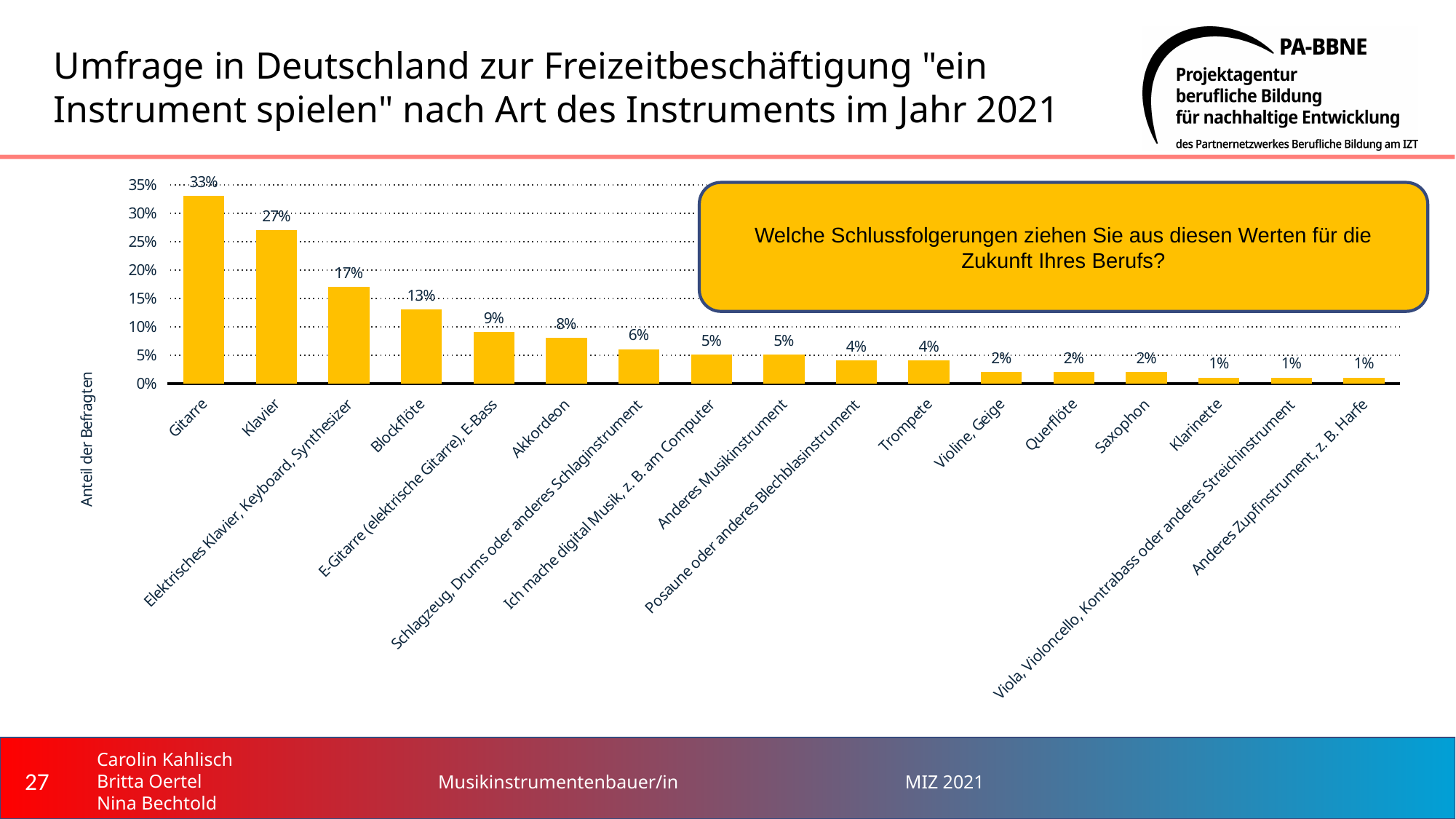
Which is larger, the value for Akkordeon or the value for Trompete? Akkordeon What is the value for Blockflöte? 13% What is the value for Trompete? 4% What is the difference between the values for Gitarre and Klavier? 6% What is the label of the vertical axis? Anteil der Befragten What kind of chart is shown on the slide? Bar chart What is the value for Saxophon? 2% How many instrument categories are shown in the chart? 17 What is the value for Gitarre? 33% What is the difference between the values for Elektrisches Klavier, Keyboard, Synthesizer and Blockflöte? 4% What is the value for Akkordeon? 8% Which instrument has the highest share? Gitarre